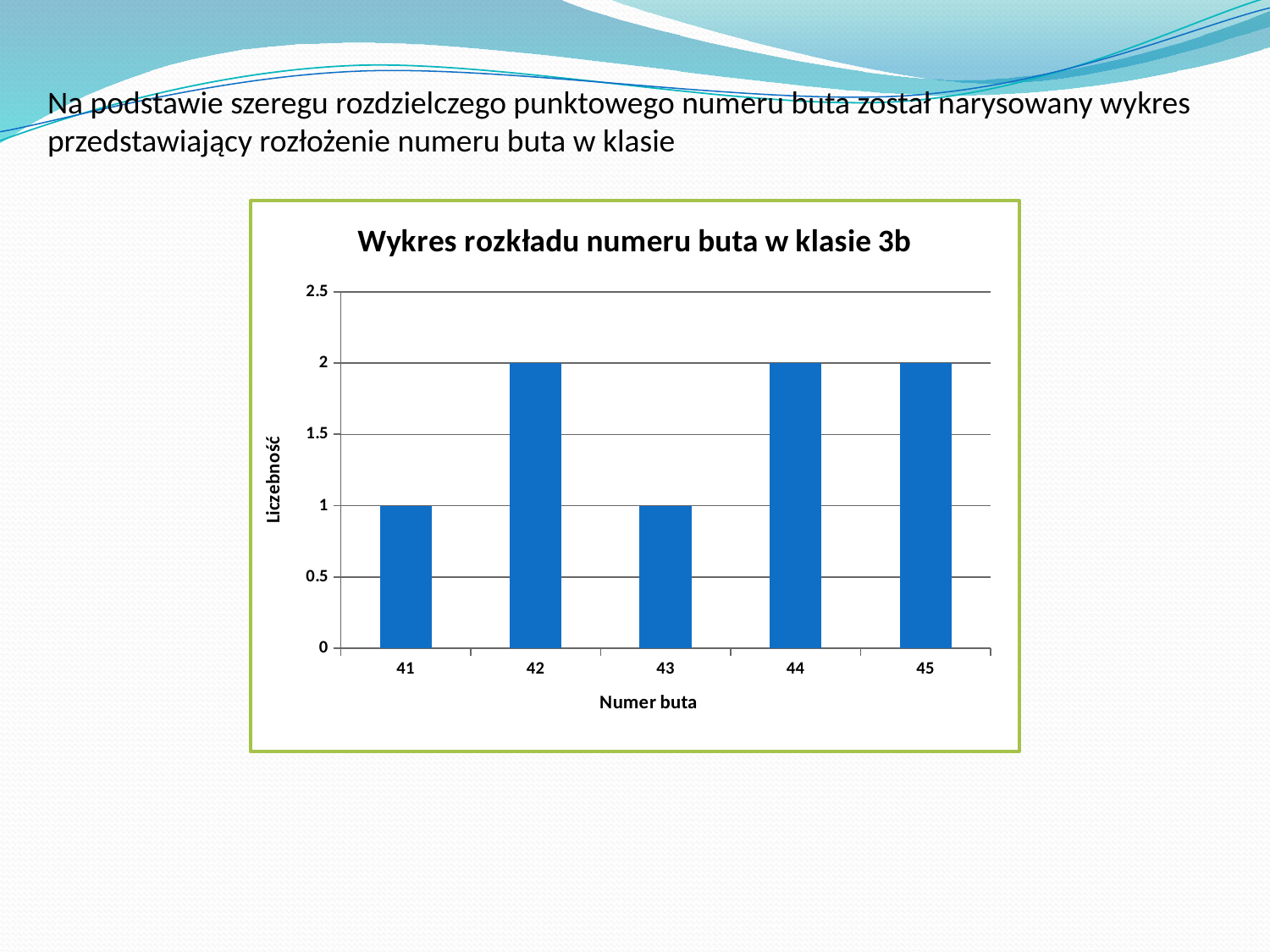
Which has the larger value, shoe size 42 or shoe size 43? 42 How many shoe size categories are shown on the x axis? 5 Is the value for shoe size 42 greater or less than 1.5? greater What is the value for shoe size 42? 2 What is the value for shoe size 41? 1 What kind of chart is shown on the slide? bar chart What is the value for shoe size 43? 1 What is the difference between the values for shoe size 44 and shoe size 43? 1 Which has the larger value, shoe size 41 or shoe size 44? 44 What is the value for shoe size 45? 2 Is the value for shoe size 41 greater or less than 1.5? less What is the title of the chart? Wykres rozkładu numeru buta w klasie 3b